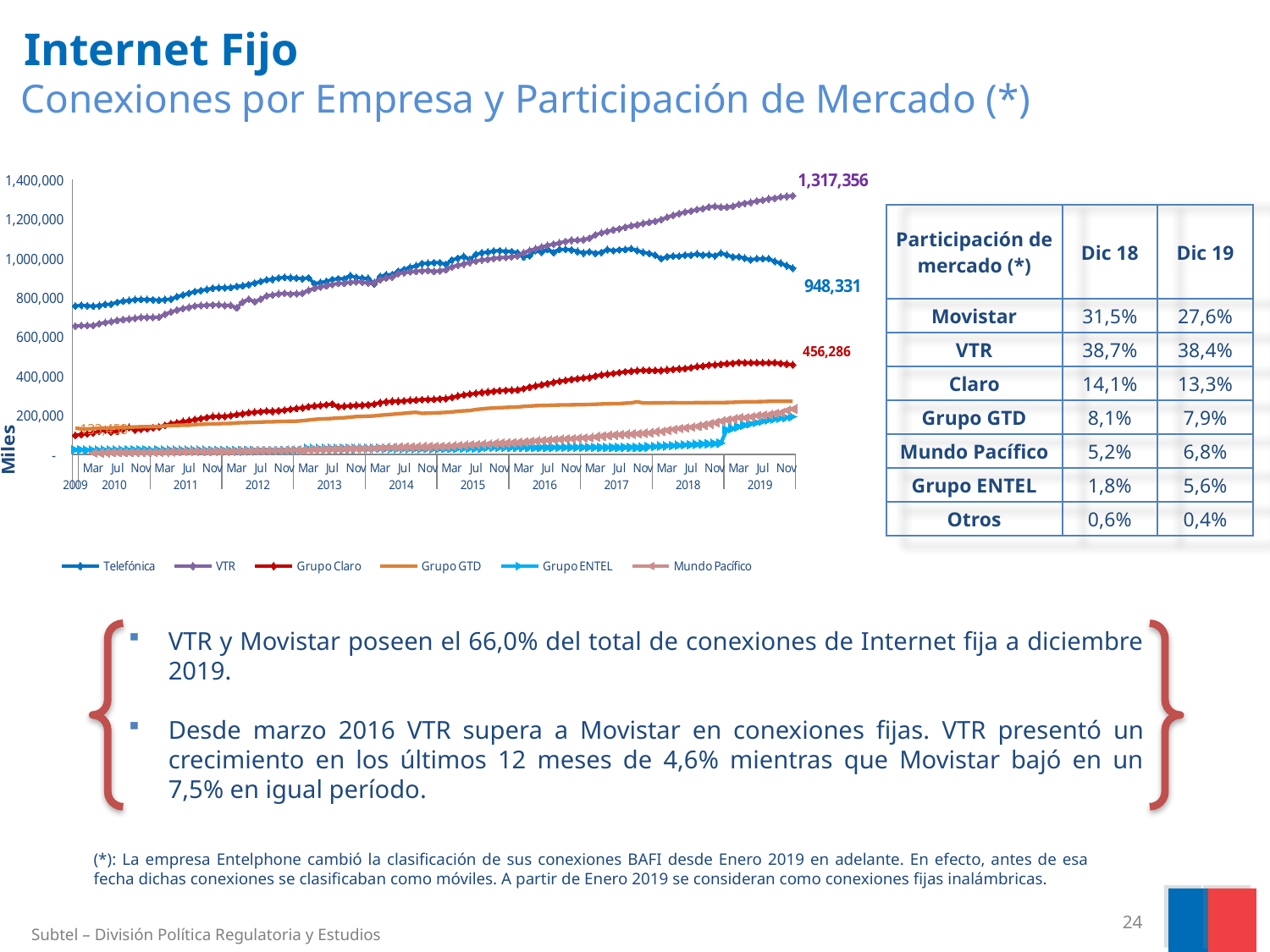
What is the difference between the final labelled values of Telefónica and Grupo Claro? 492,045 Is the value for Grupo GTD at the end of the chart greater or less than 400,000? less At the end of the chart, which is larger: VTR or Telefónica? VTR What is the final labelled value for Grupo Claro on the chart? 456,286 What is the final labelled value for VTR on the chart? 1,317,356 What kind of chart is shown on the slide? line chart How many series does the chart legend list? 6 What is the difference between the final labelled values of VTR and Telefónica? 369,025 What is the final labelled value for Telefónica on the chart? 948,331 What is the label on the vertical axis of the chart? Miles Which series has the highest value at the end of the chart (Nov 2019)? VTR Does the VTR series rise or fall over the period shown on the chart? rise